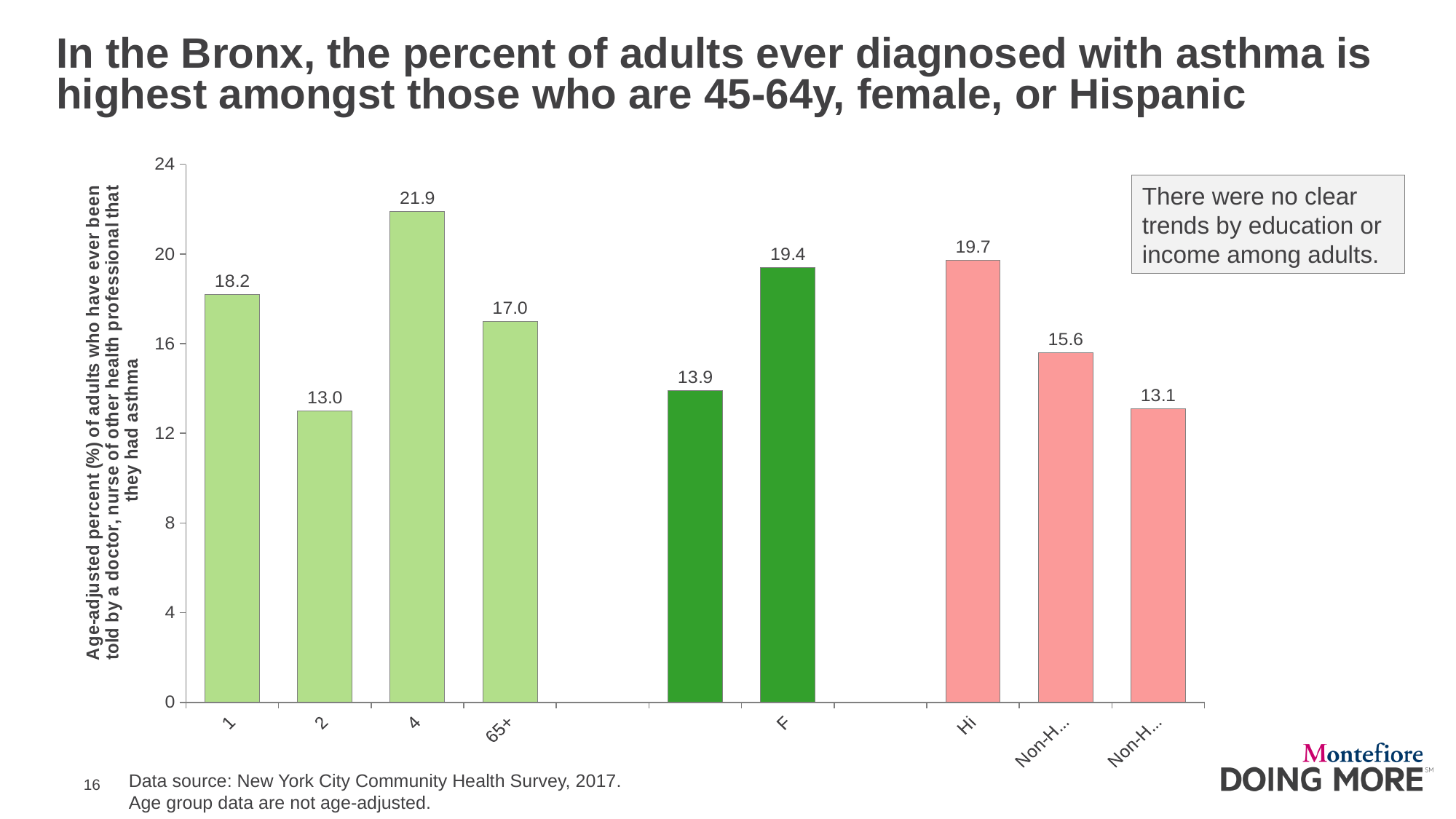
What kind of chart is shown on the slide? Bar chart What is the difference between the values for Hi and F? 0.3 What is the value for the category labelled Hi? 19.7 What is the highest value shown on the chart? 21.9 What is the lowest value shown on the chart? 13.0 What is the value of the rightmost bar in the chart? 13.1 Which has the larger value, 65+ or F? F How many bars are plotted in the chart? 9 What is the value for the 65+ category? 17.0 What is the difference between the value for 65+ and the value of the rightmost bar? 3.9 According to the text box on the slide, were there clear trends by education or income among adults? No What is the value for the category labelled F? 19.4